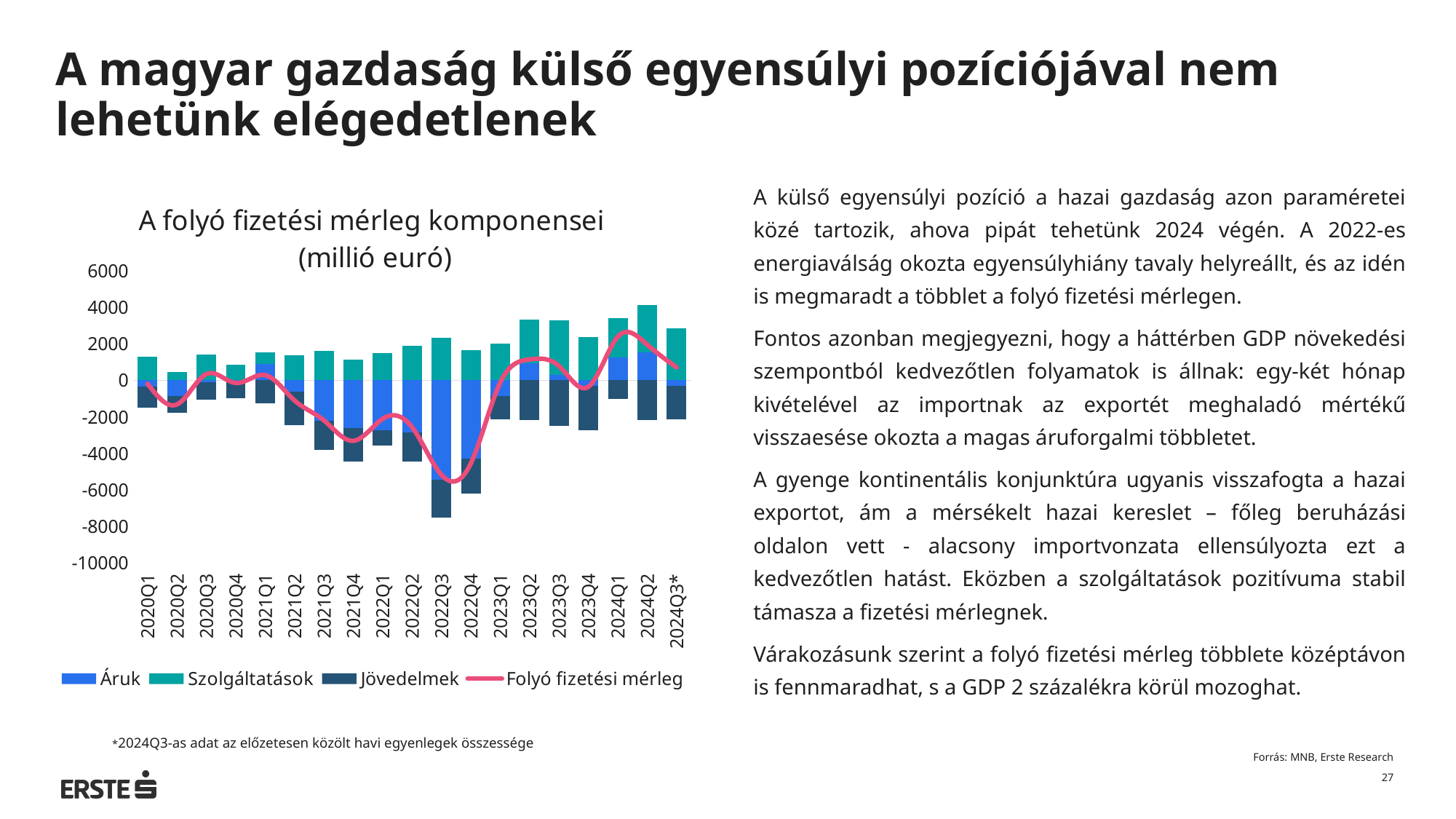
Is the Folyó fizetési mérleg value for 2024Q1 greater or less than 2000? greater In which quarter does the Folyó fizetési mérleg line reach its highest value? 2024Q1 How many quarters are shown on the x axis of the chart? 19 What kind of chart is shown on the slide? Stacked bar chart with a line Does the Folyó fizetési mérleg line rise or fall between 2022Q4 and 2024Q1? rise Which series is drawn as a line in the chart? Folyó fizetési mérleg What is the title of the chart? A folyó fizetési mérleg komponensei (millió euró) Is the Jövedelmek value for 2022Q3 greater or less than -6000? greater Is the Áruk value for 2022Q3 greater or less than -2000? less How many series does the legend list? 4